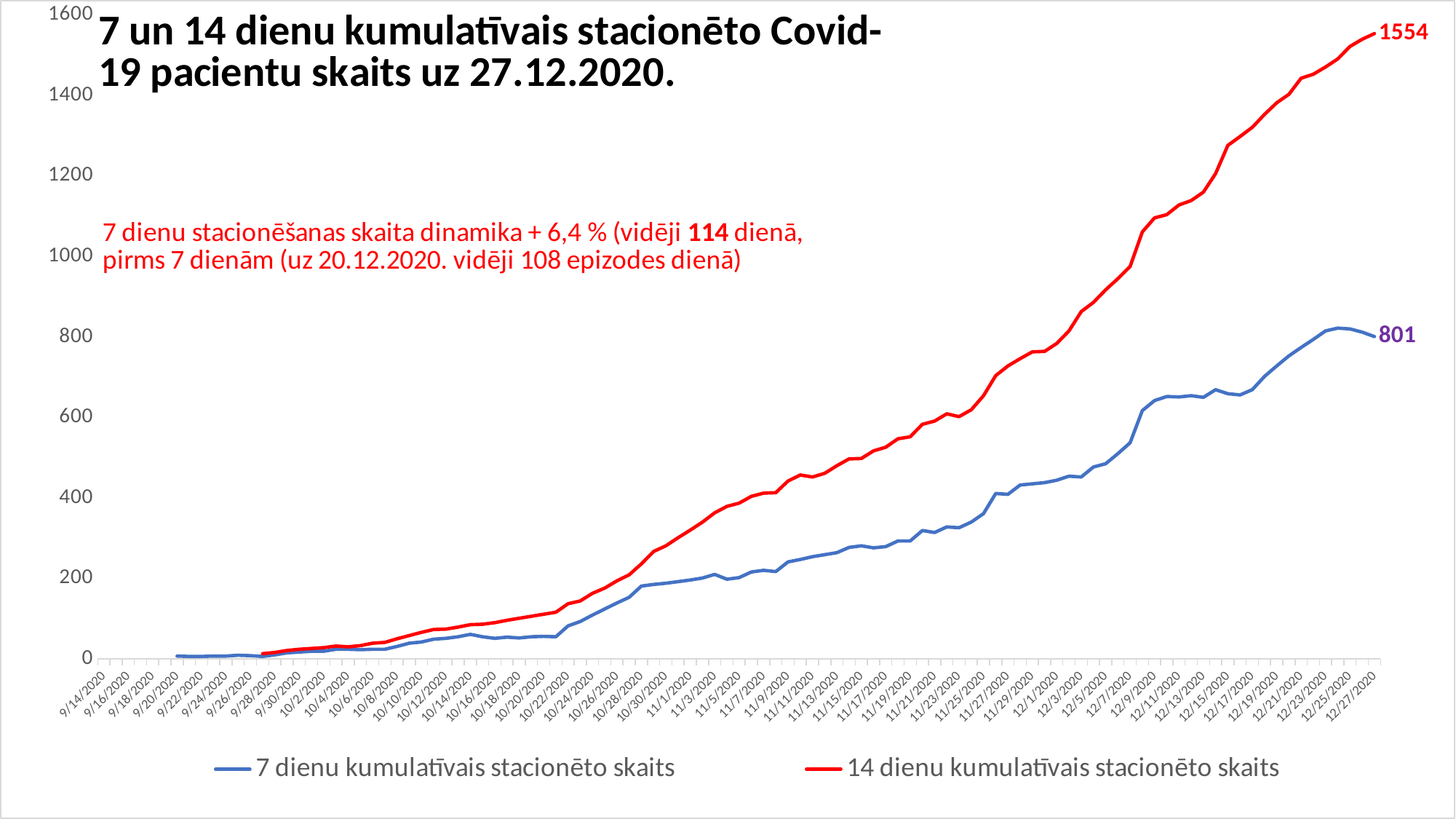
Is the value of the 7 dienu kumulatīvais stacionēto skaits series on 12/17/2020 greater or less than 800? less What is the value of the 7 dienu kumulatīvais stacionēto skaits series at 12/27/2020? 801 Which series has the larger value at 12/27/2020, 7 dienu or 14 dienu kumulatīvais stacionēto skaits? 14 dienu kumulatīvais stacionēto skaits Is the value of the 7 dienu kumulatīvais stacionēto skaits series on 12/9/2020 greater or less than 600? greater What is the difference between the 14 dienu and 7 dienu values at 12/27/2020? 753 What kind of chart is shown on the slide? line chart How many series does the legend list? 2 Is the value of the 14 dienu kumulatīvais stacionēto skaits series on 11/3/2020 greater or less than 400? less What is the value of the 14 dienu kumulatīvais stacionēto skaits series at 12/27/2020? 1554 Do the values of the 14 dienu kumulatīvais stacionēto skaits series rise or fall from 9/28/2020 to 12/27/2020? rise What colour is the line for the 14 dienu kumulatīvais stacionēto skaits series? red